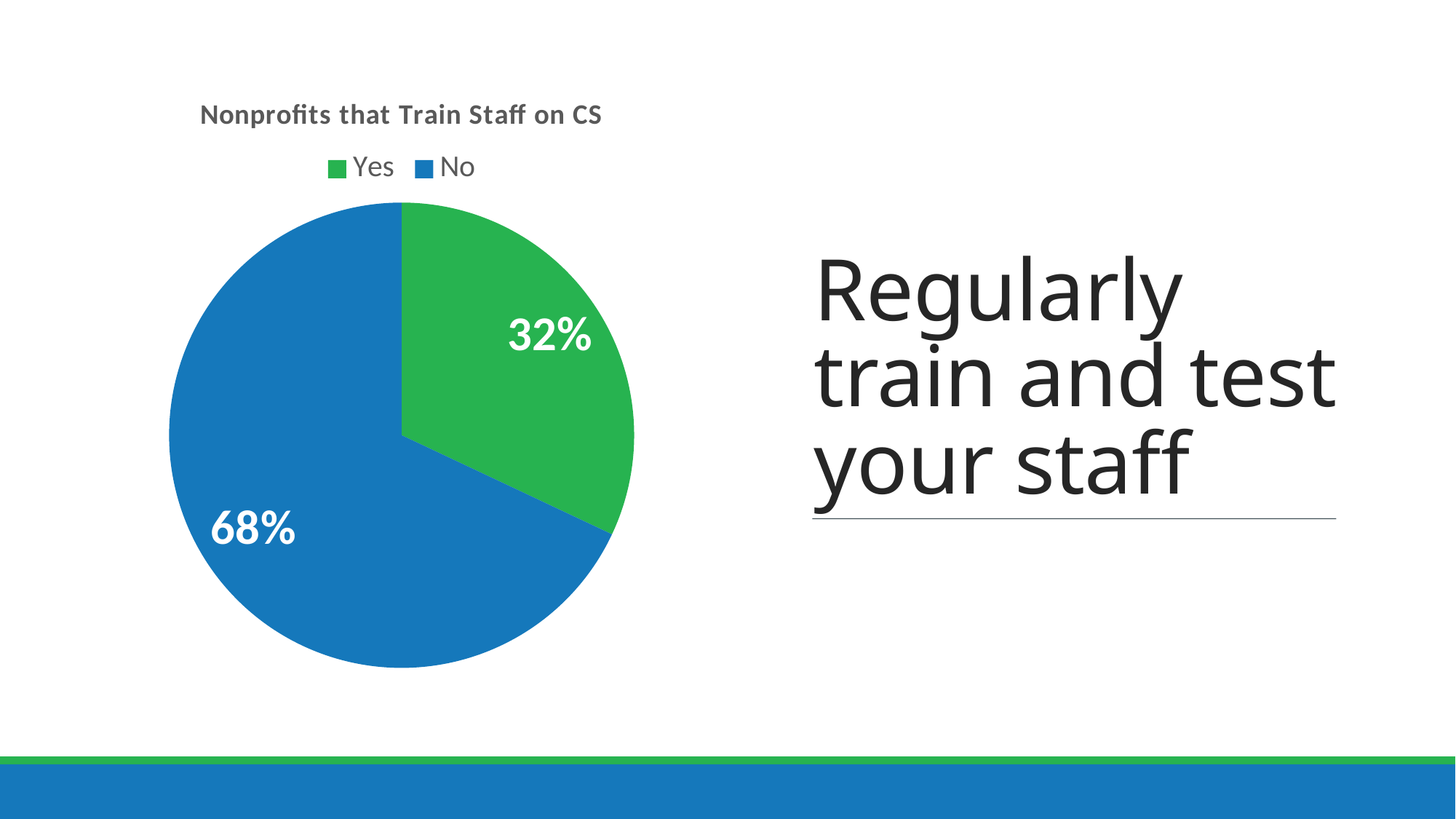
What colour is the Yes slice? green What percentage of nonprofits answered No? 68% How many entries does the legend list? 2 What type of chart is shown on the slide? pie chart Which category has the largest share of the pie? No Which category has the smallest share of the pie? Yes What is the title of the chart? Nonprofits that Train Staff on CS How many slices does the pie chart have? 2 What share of the pie does the No slice represent? 68% Which is larger, the Yes slice or the No slice? No What is the difference in percentage points between the No and Yes slices? 36 What percentage of nonprofits answered Yes? 32%